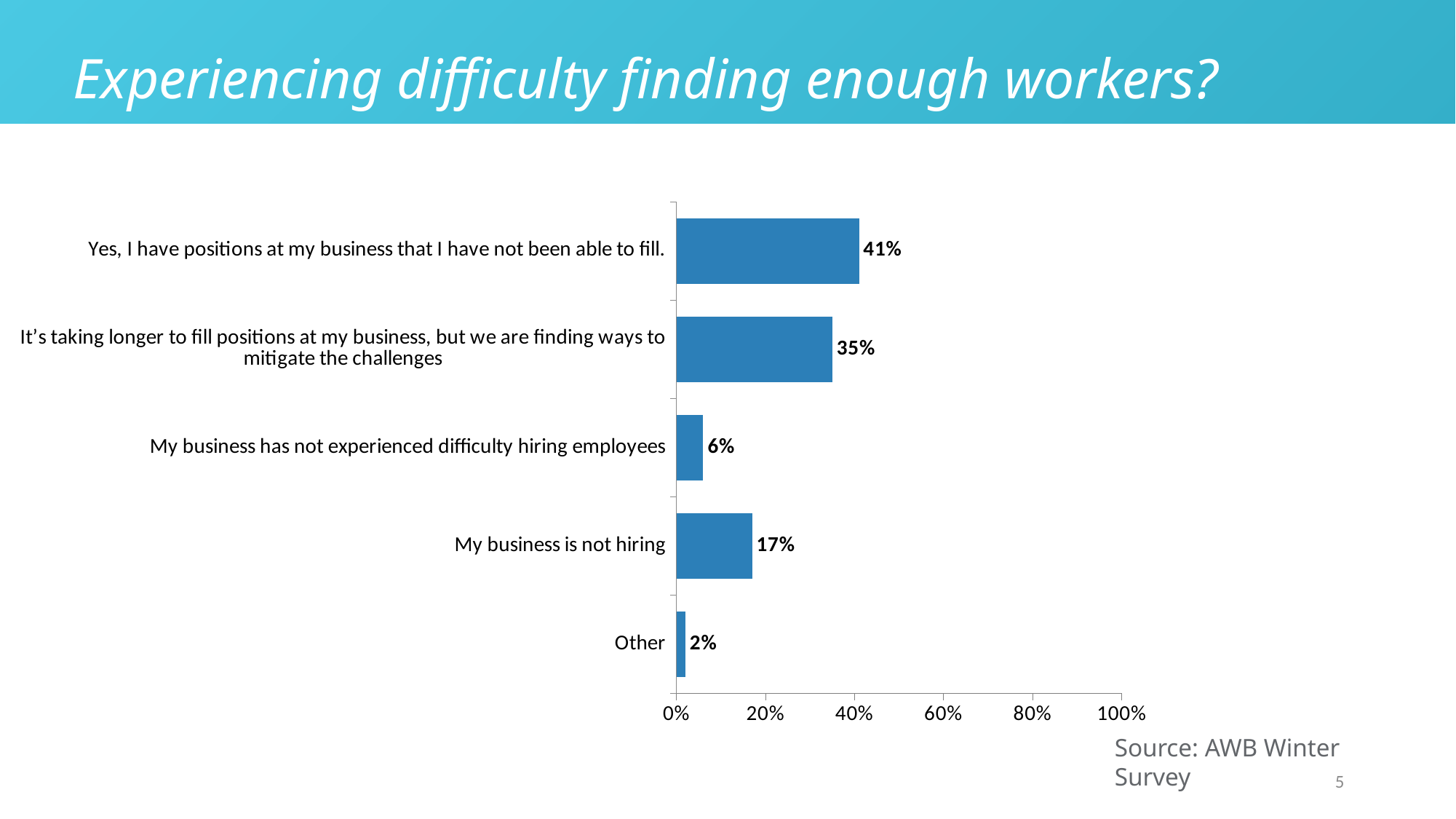
What is the source cited for the chart? AWB Winter Survey What percentage of respondents said their business has not experienced difficulty hiring employees? 6% What is the value for "My business is not hiring"? 17% What percentage of respondents said they have positions at their business that they have not been able to fill? 41% Which category has the lowest value? Other What is the difference between the value for "Yes, I have positions at my business that I have not been able to fill." and the value for "It's taking longer to fill positions at my business, but we are finding ways to mitigate the challenges"? 6% What is the value for "Other"? 2% Which is larger: the value for "My business is not hiring" or the value for "My business has not experienced difficulty hiring employees"? My business is not hiring Is the value for "It's taking longer to fill positions at my business, but we are finding ways to mitigate the challenges" greater or less than 40%? less Which category has the highest value? Yes, I have positions at my business that I have not been able to fill. What kind of chart is shown on the slide? Bar chart How many categories are shown in the chart? 5